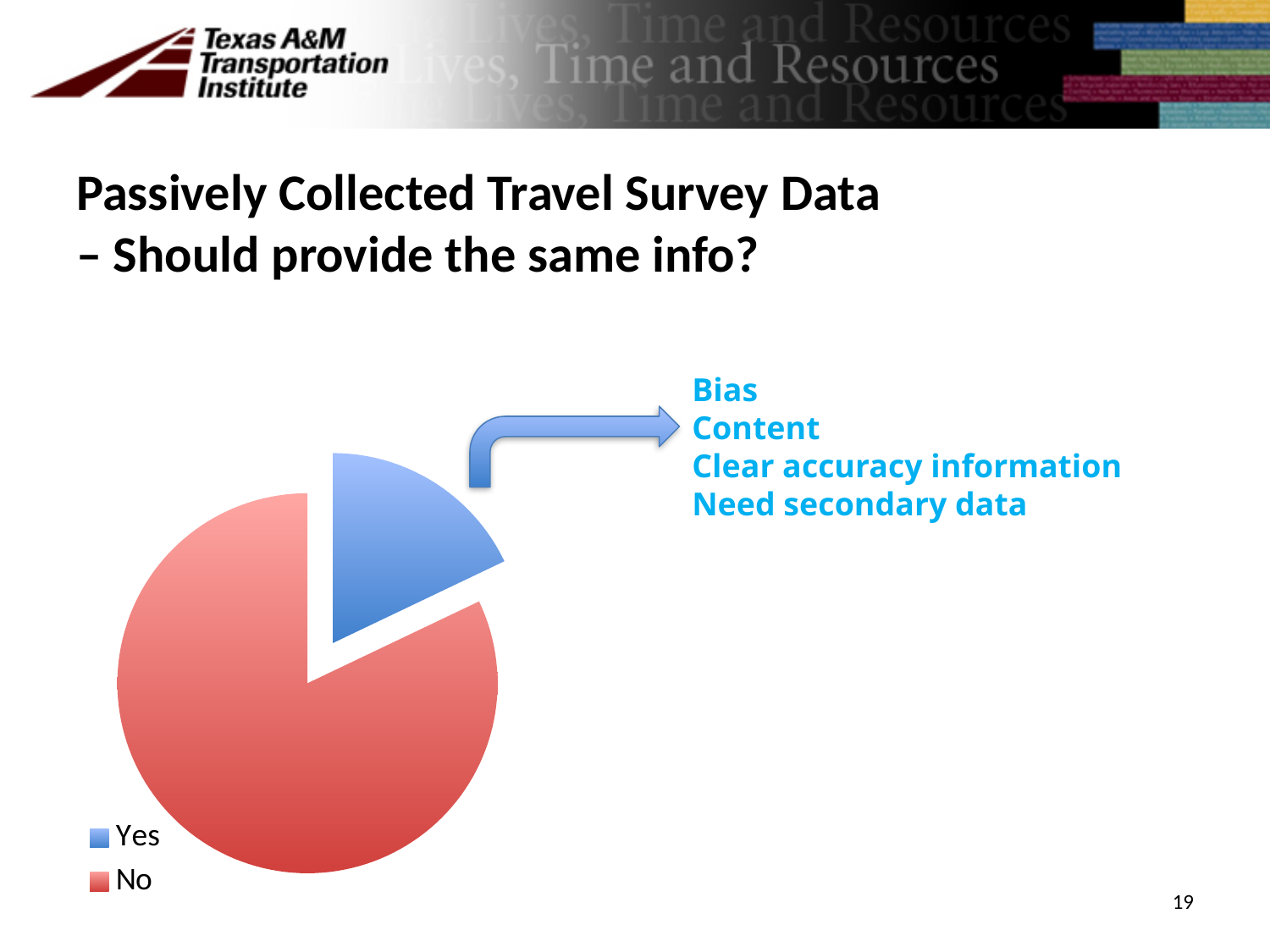
What are the two categories listed in the pie chart's legend? Yes and No What colour is the Yes slice in the pie chart? blue Which slice of the pie chart is pulled out (exploded) from the rest of the pie? Yes How many entries does the legend of the pie chart list? 2 Which slice is larger in the pie chart, Yes or No? No What kind of chart is shown on the slide? pie chart Which category has the smallest slice in the pie chart? Yes Which category has the largest slice in the pie chart? No How many slices does the pie chart have? 2